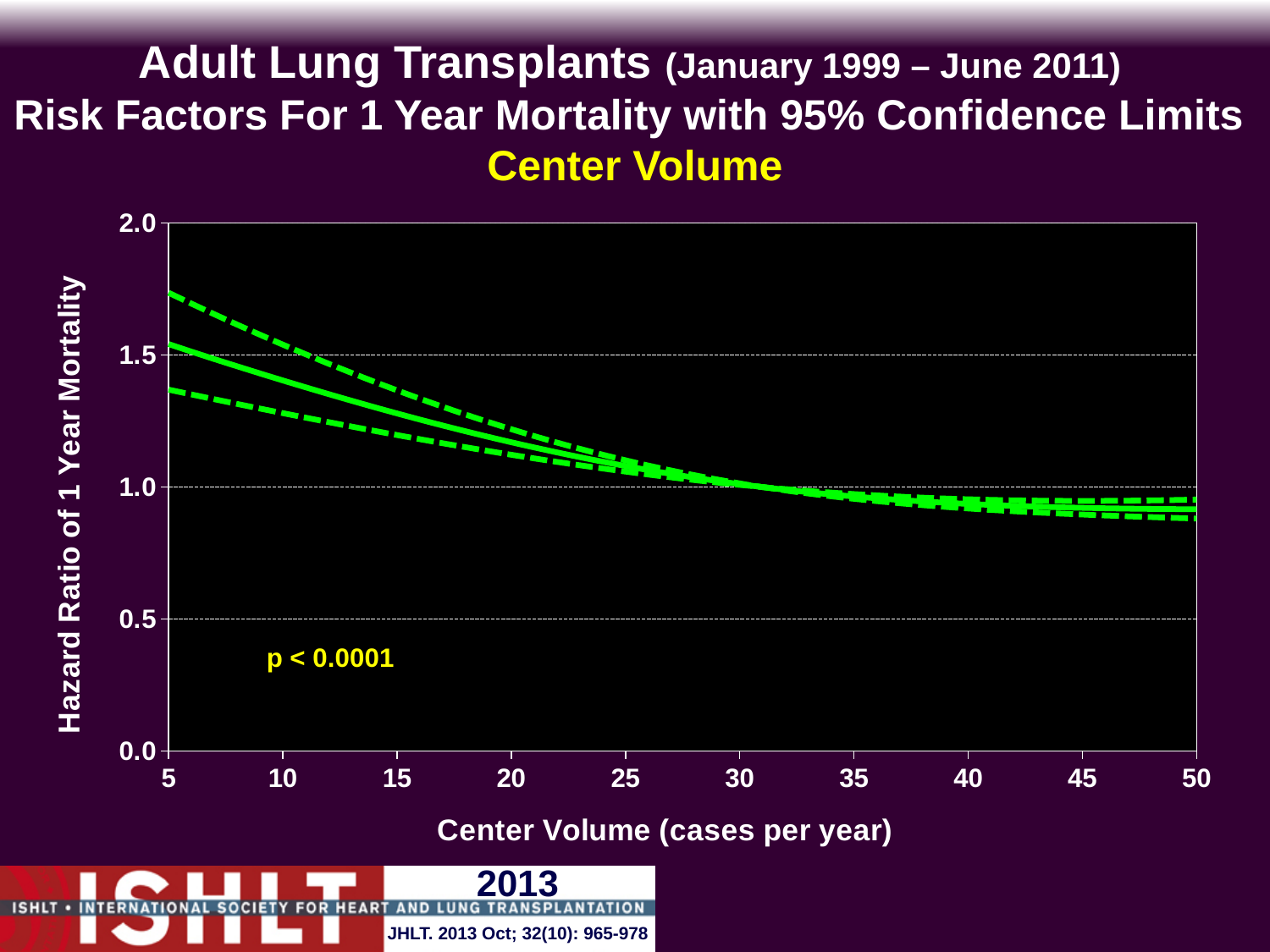
What is the p-value printed on the chart? p < 0.0001 Is the hazard ratio on the solid line at a center volume of 50 cases per year greater or less than 1.0? less What kind of chart is shown on the slide? line chart Does the hazard ratio of 1 year mortality rise or fall as center volume increases along the x axis? fall Is the hazard ratio on the solid line at a center volume of 10 cases per year greater or less than 1.0? greater Is the upper dashed confidence limit at a center volume of 5 cases per year greater or less than 1.5? greater What is the label of the x axis? Center Volume (cases per year) How many lines are plotted on the chart? 3 Is the hazard ratio at a center volume of 5 cases per year larger or smaller than at 45 cases per year? larger